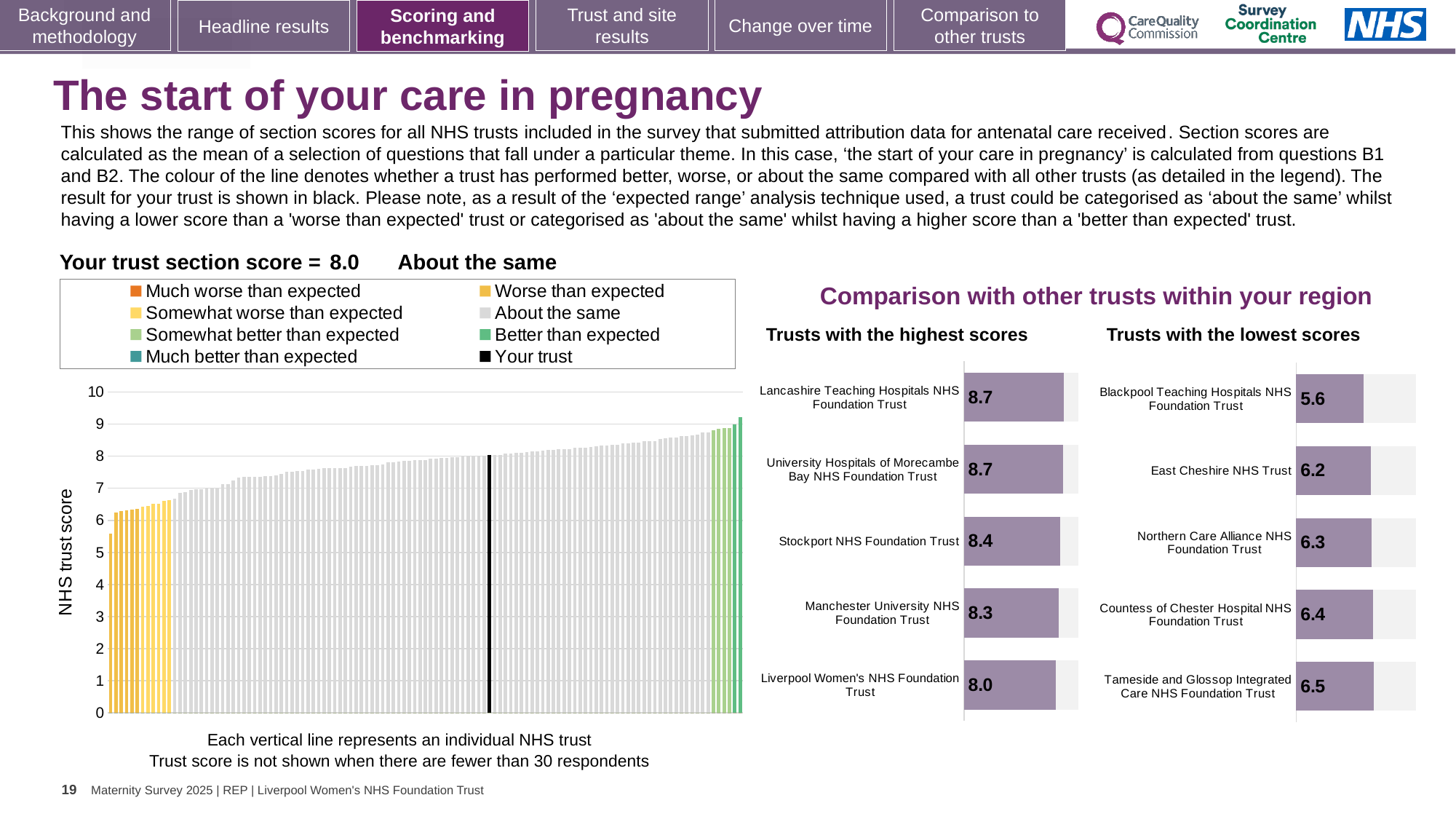
In the 'Trusts with the lowest scores' chart, what is the difference between the score for Tameside and Glossop Integrated Care NHS Foundation Trust and the score for Blackpool Teaching Hospitals NHS Foundation Trust? 0.9 In the main 'NHS trust score' chart, what is the section score for your trust (the black bar)? 8.0 In the 'Trusts with the highest scores' chart, what is the score for Stockport NHS Foundation Trust? 8.4 How many trusts are shown in the 'Trusts with the highest scores' chart? 5 In the 'Trusts with the lowest scores' chart, what is the score for Blackpool Teaching Hospitals NHS Foundation Trust? 5.6 In the main 'NHS trust score' chart, is the value of the leftmost (lowest) bar greater or less than 6? less In the 'Trusts with the lowest scores' chart, which trust has the lowest score? Blackpool Teaching Hospitals NHS Foundation Trust In the 'Trusts with the highest scores' chart, what is the difference between the score for Lancashire Teaching Hospitals NHS Foundation Trust and the score for Liverpool Women's NHS Foundation Trust? 0.7 In the main 'NHS trust score' chart, do the bar values rise or fall from left to right? rise In the 'Trusts with the lowest scores' chart, which has the higher score: East Cheshire NHS Trust or Countess of Chester Hospital NHS Foundation Trust? Countess of Chester Hospital NHS Foundation Trust In the 'Trusts with the highest scores' chart, which trust has the lowest score shown? Liverpool Women's NHS Foundation Trust How many entries does the legend above the main 'NHS trust score' chart list? 8